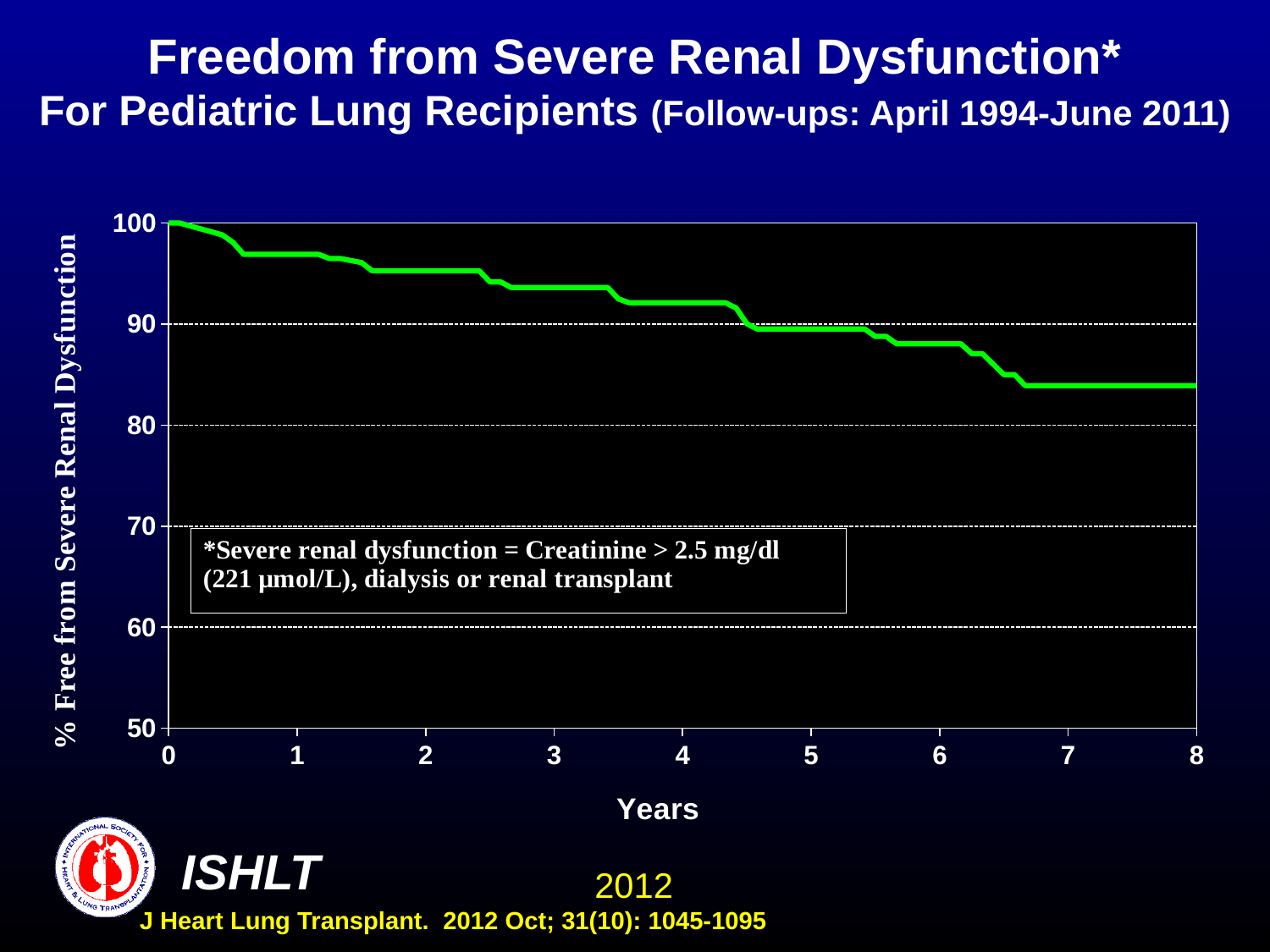
What kind of chart is shown on the slide? line chart Is the value at year 2 greater or less than 90? greater Is the value at year 1 larger or smaller than the value at year 5? larger What is the label of the x axis? Years What is the value of the curve at year 0? 100 Does the percentage free from severe renal dysfunction rise or fall as years increase? fall Is the value at year 6 greater or less than 90? less At which year on the x axis is the curve at its highest value? 0 Is the value at year 8 greater or less than 80? greater What is the lowest value shown on the y axis? 50